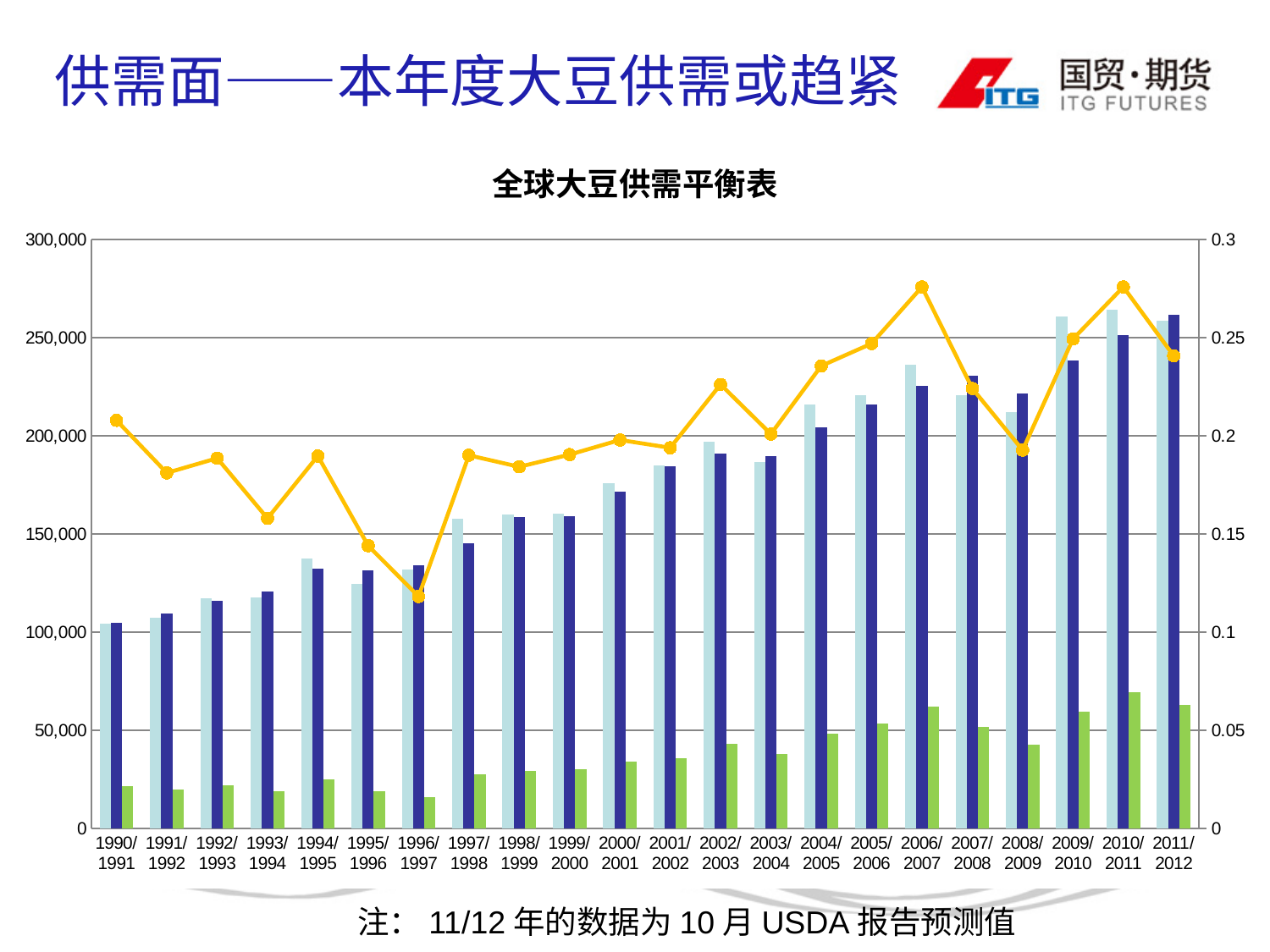
What is the title of the chart? 全球大豆供需平衡表 How many year categories are shown on the x axis? 22 Is the value of the light blue bar for 2010/2011 greater or less than 250,000? greater Which year has the higher orange line value, 2008/2009 or 2009/2010? 2009/2010 Is the value of the green bar for 2010/2011 greater or less than 50,000? greater Is the value of the dark blue bar for 1990/1991 greater or less than 150,000? less In which year category is the green bar the tallest? 2010/2011 What kind of chart is shown on the slide? Combined bar and line chart Do the light blue bars generally rise or fall from 1990/1991 to 2011/2012? rise In which year category does the orange line reach its lowest point? 1996/1997 How many bars are plotted for each year category? 3